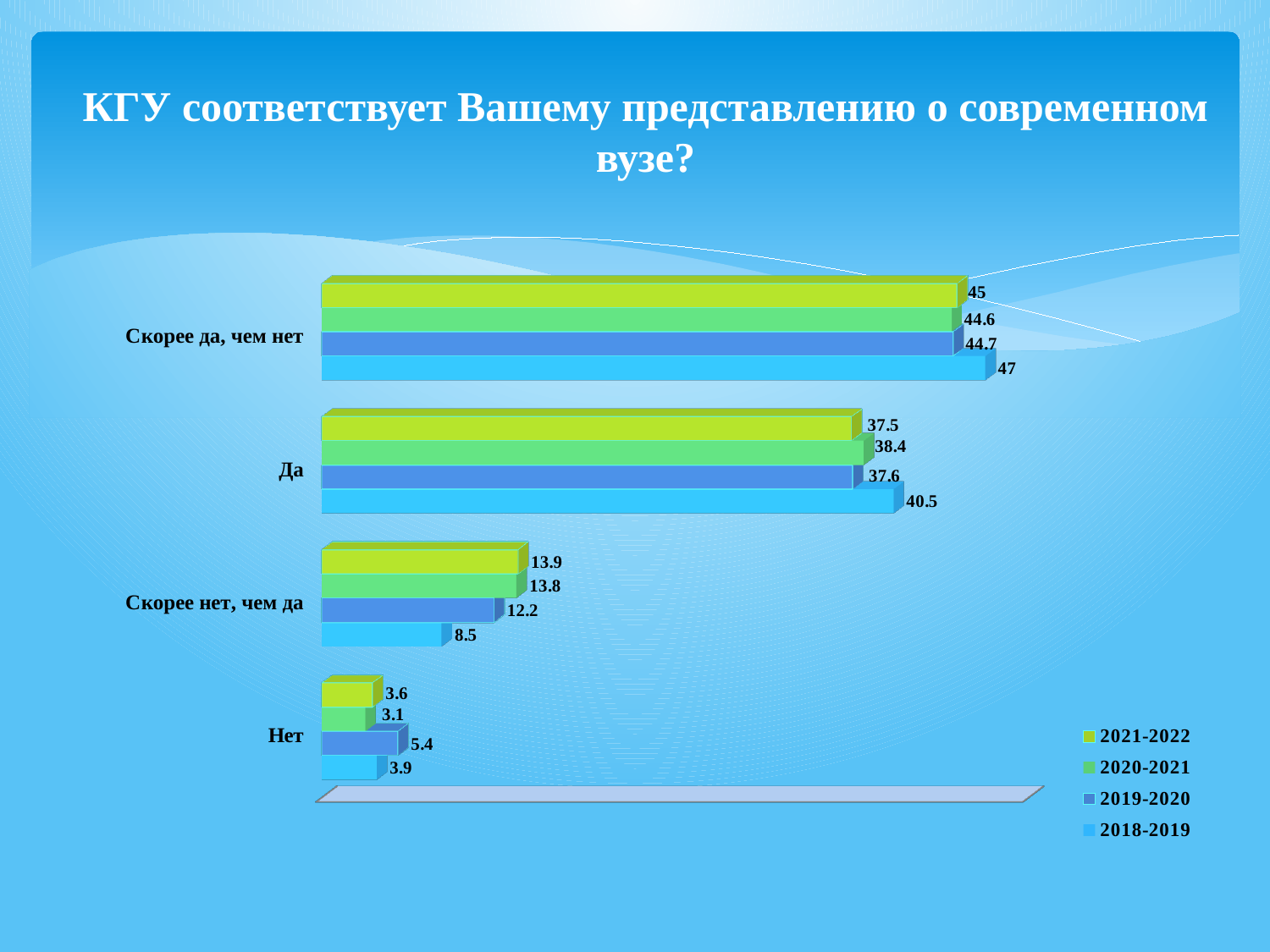
Which series is shown in the lightest blue colour in the legend? 2018-2019 How many series does the legend list? 4 What is the value for "Нет" in the 2019-2020 series? 5.4 What is the value for "Скорее да, чем нет" in the 2020-2021 series? 44.6 Which category has the lowest value in the 2021-2022 series? Нет What is the difference between the 2018-2019 and 2021-2022 values for "Скорее нет, чем да"? 5.4 Which is larger for "Да": the 2020-2021 value or the 2019-2020 value? 2020-2021 What kind of chart is shown on the slide? Bar chart What is the value for "Да" in the 2018-2019 series? 40.5 What is the value for "Скорее нет, чем да" in the 2021-2022 series? 13.9 Which category has the highest value in the 2018-2019 series? Скорее да, чем нет How many categories are shown on the chart? 4